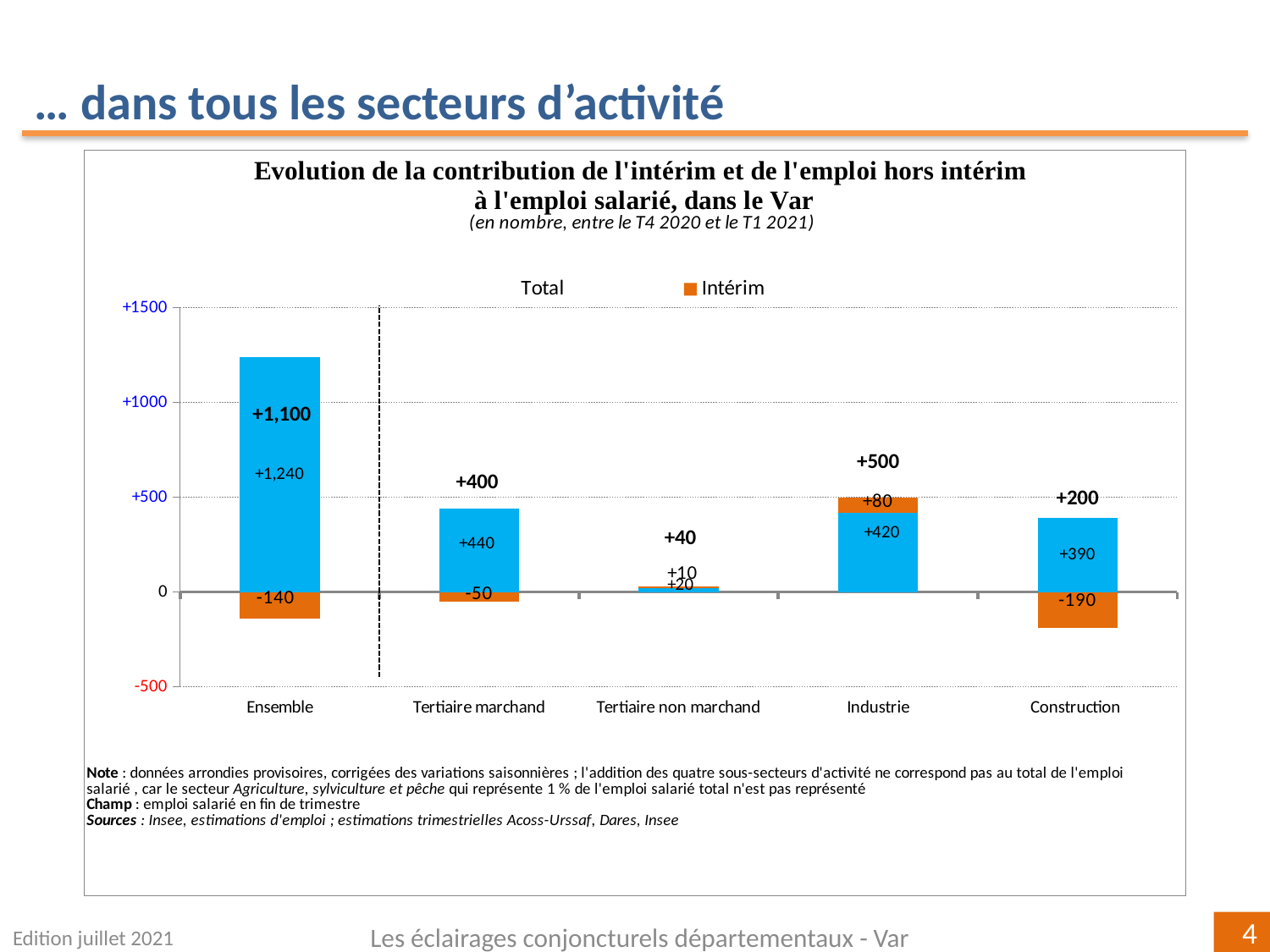
What kind of chart is this? Stacked bar chart What is the difference between the total for Industrie and the total for Construction? 300 Which category has the lowest total value? Tertiaire non marchand What is the total value shown for Ensemble? +1,100 What is the value of the blue (non-intérim) segment for Tertiaire marchand? +440 What is the Intérim value for Construction? -190 How many categories are shown on the x axis? 5 What is the Intérim value for Industrie? +80 Which is larger, the total for Tertiaire marchand or the total for Industrie? Industrie Which series is shown in orange according to the legend? Intérim Is the blue segment for Ensemble greater or less than +1000? greater Which category has the highest total value? Ensemble